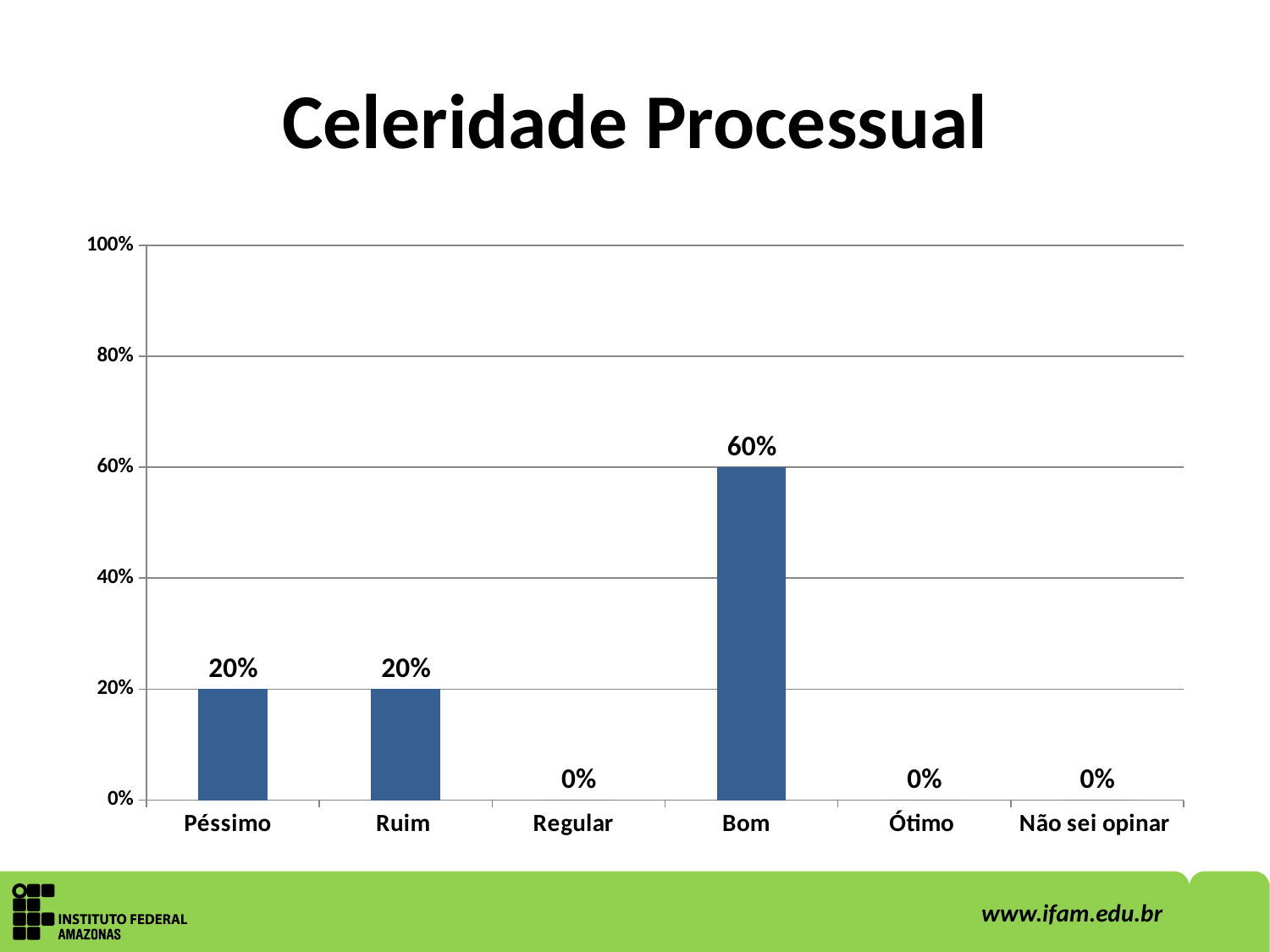
How many categories are shown on the x axis? 6 Which category has the highest value? Bom What is the value for Péssimo? 20% Which is larger, the value for Bom or the value for Péssimo? Bom What is the value for Não sei opinar? 0% What is the value for Bom? 60% What is the difference between the values for Bom and Ruim? 40% What kind of chart is shown on the slide? bar chart Is the value for Bom greater or less than 40%? greater What is the value for Regular? 0% What is the title of the chart? Celeridade Processual How many categories have a value of 0%? 3